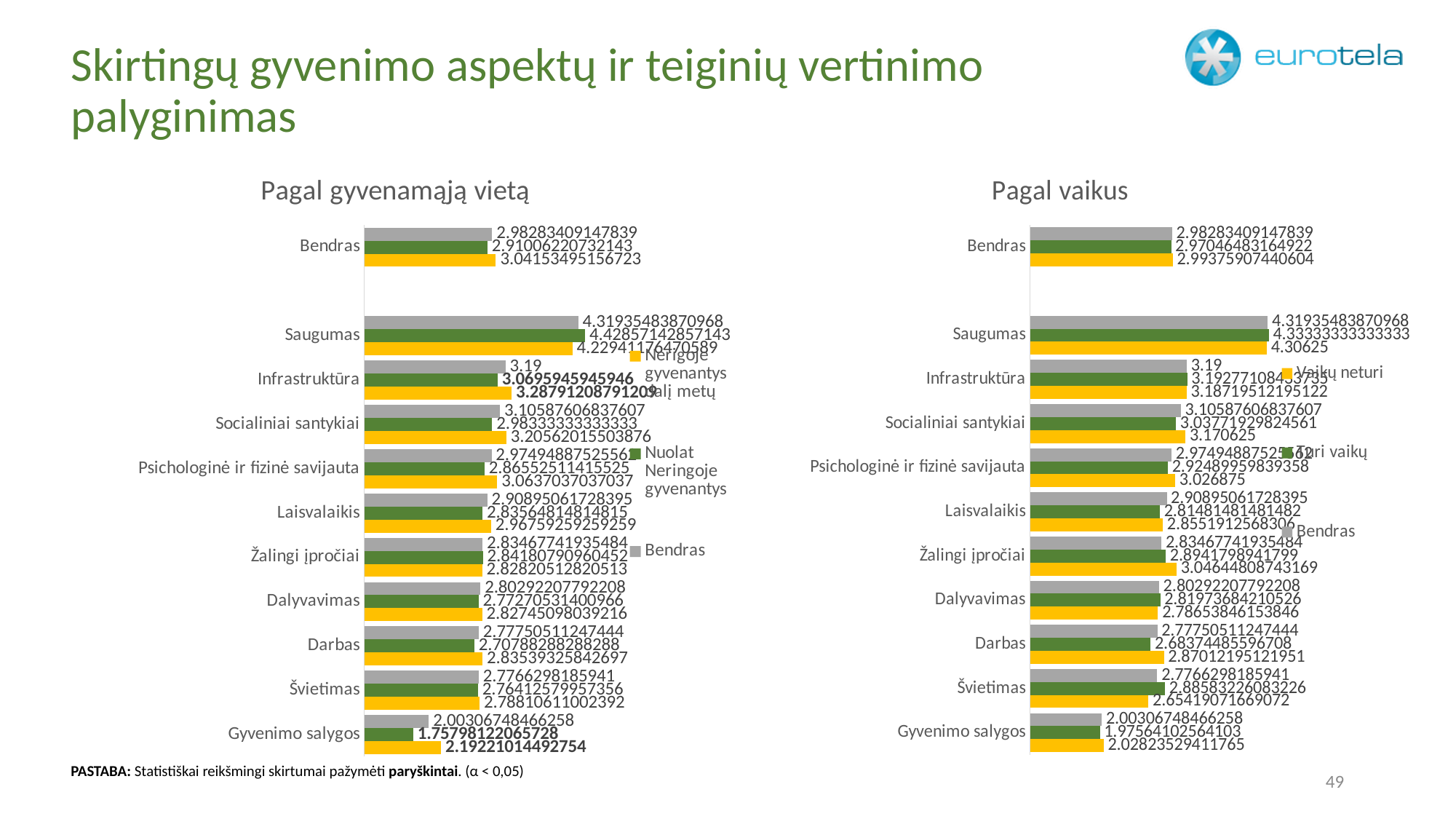
In the "Pagal gyvenamąją vietą" chart, which category has the highest "Bendras" value? Saugumas In the "Pagal vaikus" chart, what is the value of "Vaikų neturi" for Saugumas? 4.30625 What kind of chart is the "Pagal gyvenamąją vietą" chart? bar chart In the "Pagal vaikus" chart, what is the value of "Vaikų neturi" for Psichologinė ir fizinė savijauta? 3.026875 In the "Pagal vaikus" chart, which is larger for Švietimas: "Turi vaikų" or "Vaikų neturi"? Turi vaikų In the "Pagal gyvenamąją vietą" chart, what is the "Bendras" value for Infrastruktūra? 3.19 Which series is shown in yellow in the "Pagal vaikus" chart? Vaikų neturi How many series does the legend of the "Pagal vaikus" chart list? 3 In the "Pagal vaikus" chart, what is the value of "Vaikų neturi" for Socialiniai santykiai? 3.170625 In the "Pagal gyvenamąją vietą" chart, what is the value of "Nuolat Neringoje gyvenantys" for Gyvenimo salygos? 1.75798122065728 How many categories are shown on the "Pagal gyvenamąją vietą" chart? 11 In the "Pagal vaikus" chart, which category has the lowest "Turi vaikų" value? Gyvenimo salygos